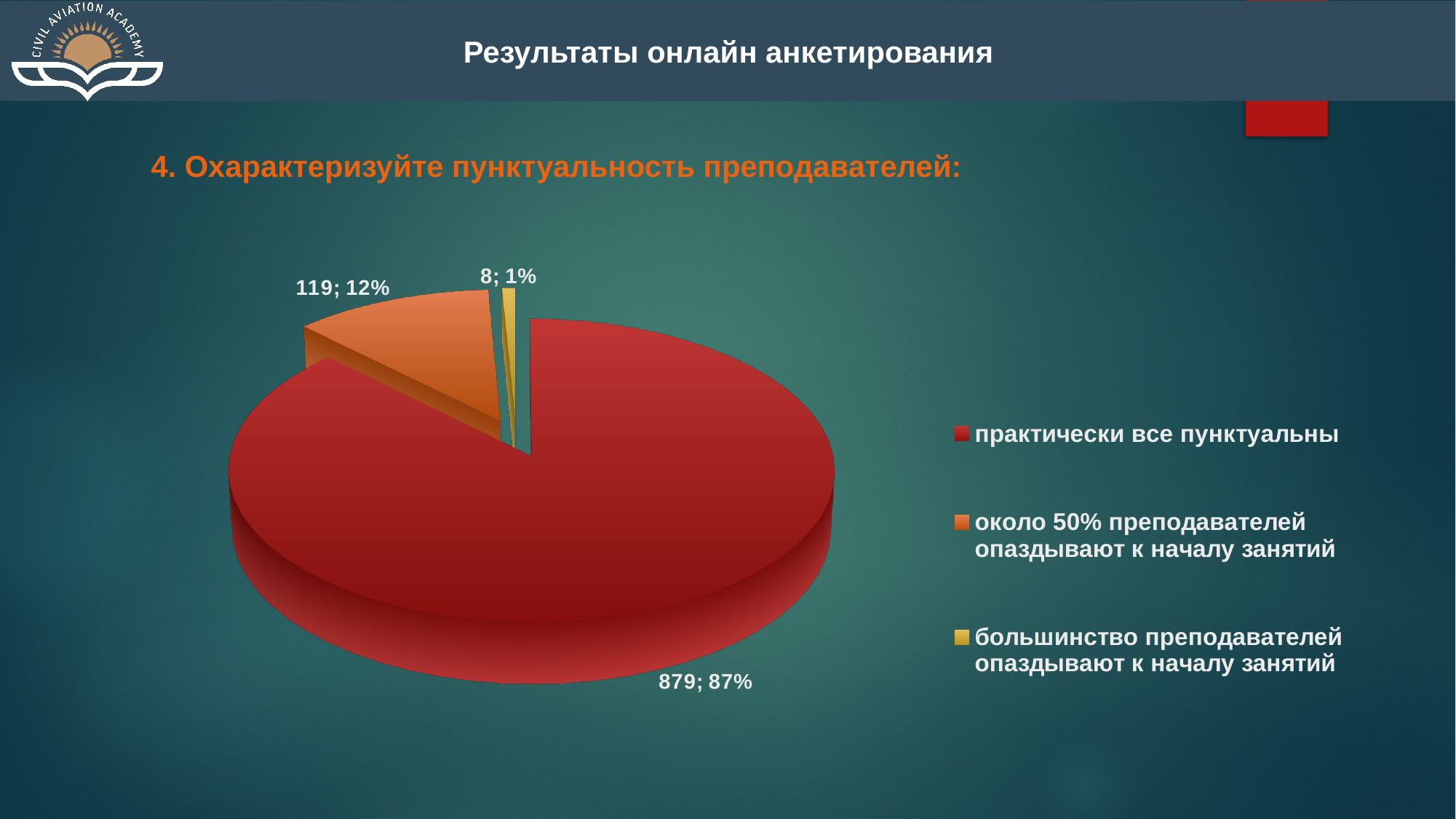
How many entries does the legend list? 3 How many respondents chose "практически все пунктуальны"? 879 What share of the pie does "около 50% преподавателей опаздывают к началу занятий" take? 12% How many slices does the pie chart have? 3 How many respondents chose "около 50% преподавателей опаздывают к началу занятий"? 119 What is the difference between the counts for "практически все пунктуальны" and "около 50% преподавателей опаздывают к началу занятий"? 760 What colour is the slice for "практически все пунктуальны"? red Which category has the largest slice? практически все пунктуальны What share of the pie does "практически все пунктуальны" take? 87% What kind of chart is shown on the slide? pie chart How many respondents chose "большинство преподавателей опаздывают к началу занятий"? 8 Which category has the smallest slice? большинство преподавателей опаздывают к началу занятий